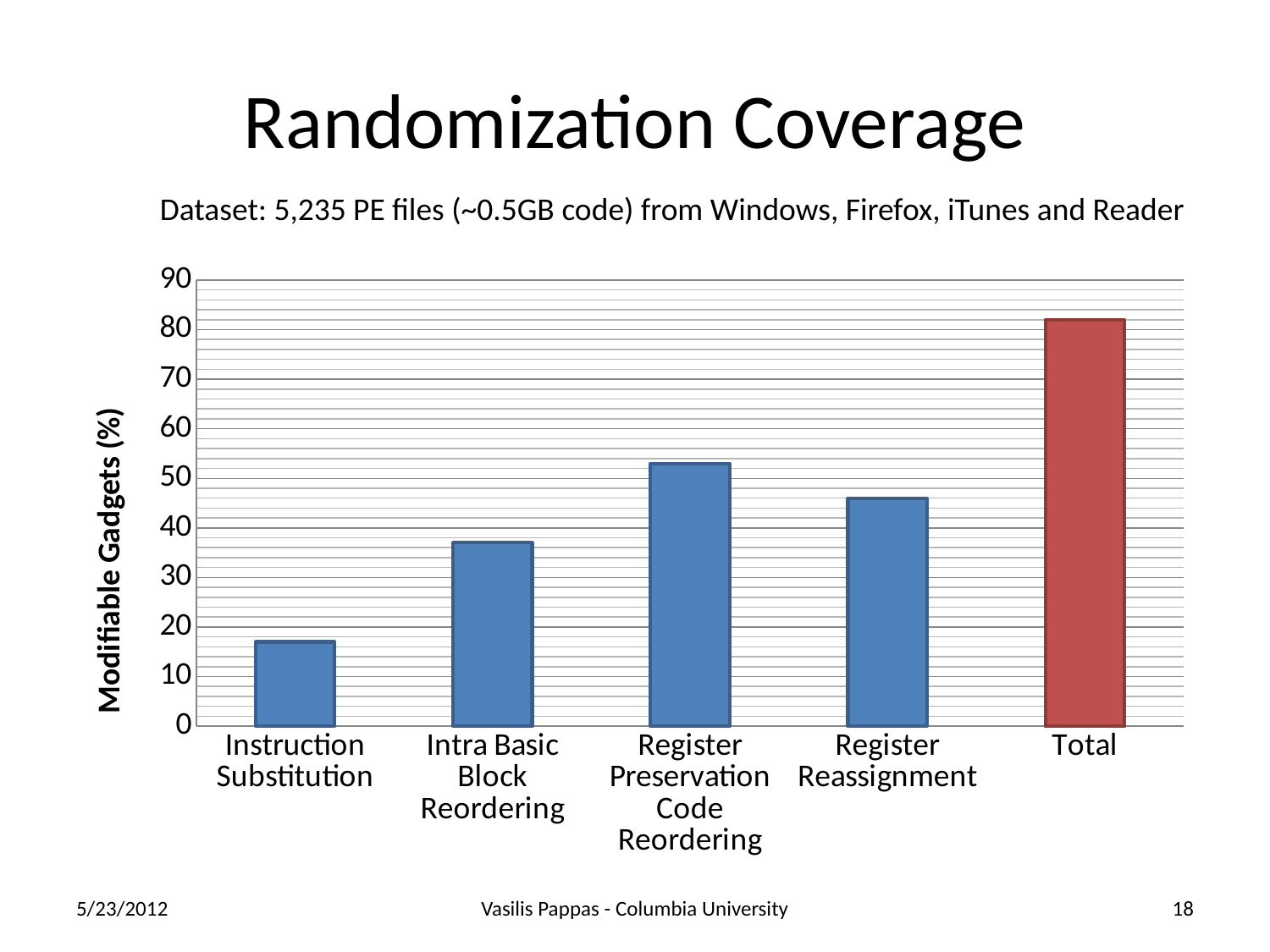
Is the value for Register Reassignment greater or less than 50? less Which category has the highest value? Total Which is larger, the value for Register Preservation Code Reordering or the value for Register Reassignment? Register Preservation Code Reordering Is the value for Instruction Substitution greater or less than 20? less Is the value for Total greater or less than 80? greater Which is larger, the value for Intra Basic Block Reordering or the value for Instruction Substitution? Intra Basic Block Reordering Which category has the lowest value? Instruction Substitution How many categories are plotted on the x axis? 5 What kind of chart is shown on the slide? bar chart What is the label of the y axis? Modifiable Gadgets (%)